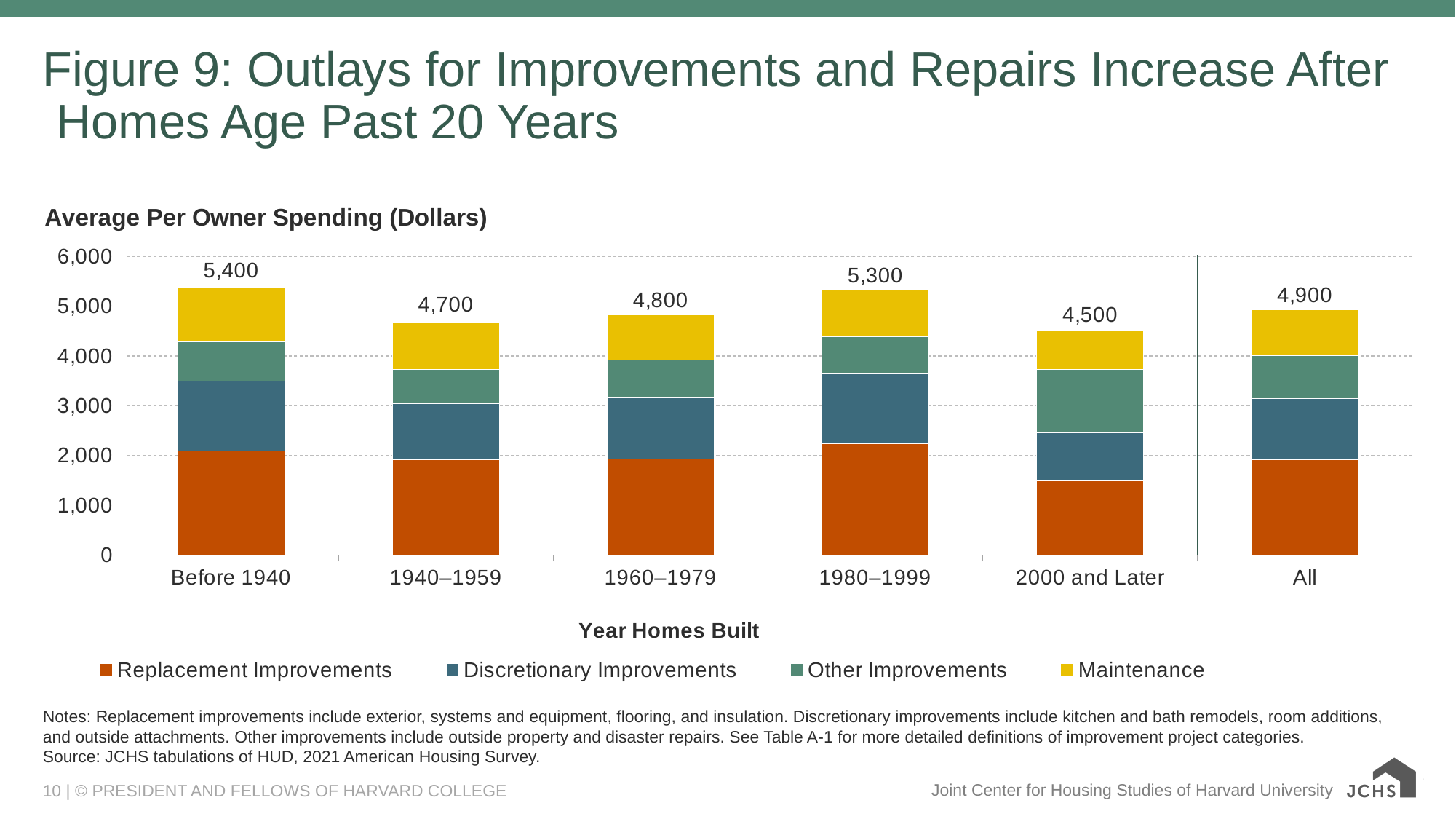
Is the Replacement Improvements value for homes built 2000 and Later greater or less than 2,000? less Which series is shown in yellow in the legend? Maintenance What is the total average per owner spending for homes built 2000 and Later? 4,500 What kind of chart is shown on the slide? Stacked bar chart Which year-built category has the highest total average per owner spending? Before 1940 What is the total average per owner spending for homes built Before 1940? 5,400 Which year-built category has the lowest total average per owner spending? 2000 and Later What is the difference in total spending between homes built Before 1940 and homes built 2000 and Later? 900 What is the total average per owner spending for the All category? 4,900 Which has a higher total average per owner spending: 1940–1959 or 1980–1999? 1980–1999 How many year-built categories are shown on the x axis? 6 How many series does the legend list? 4